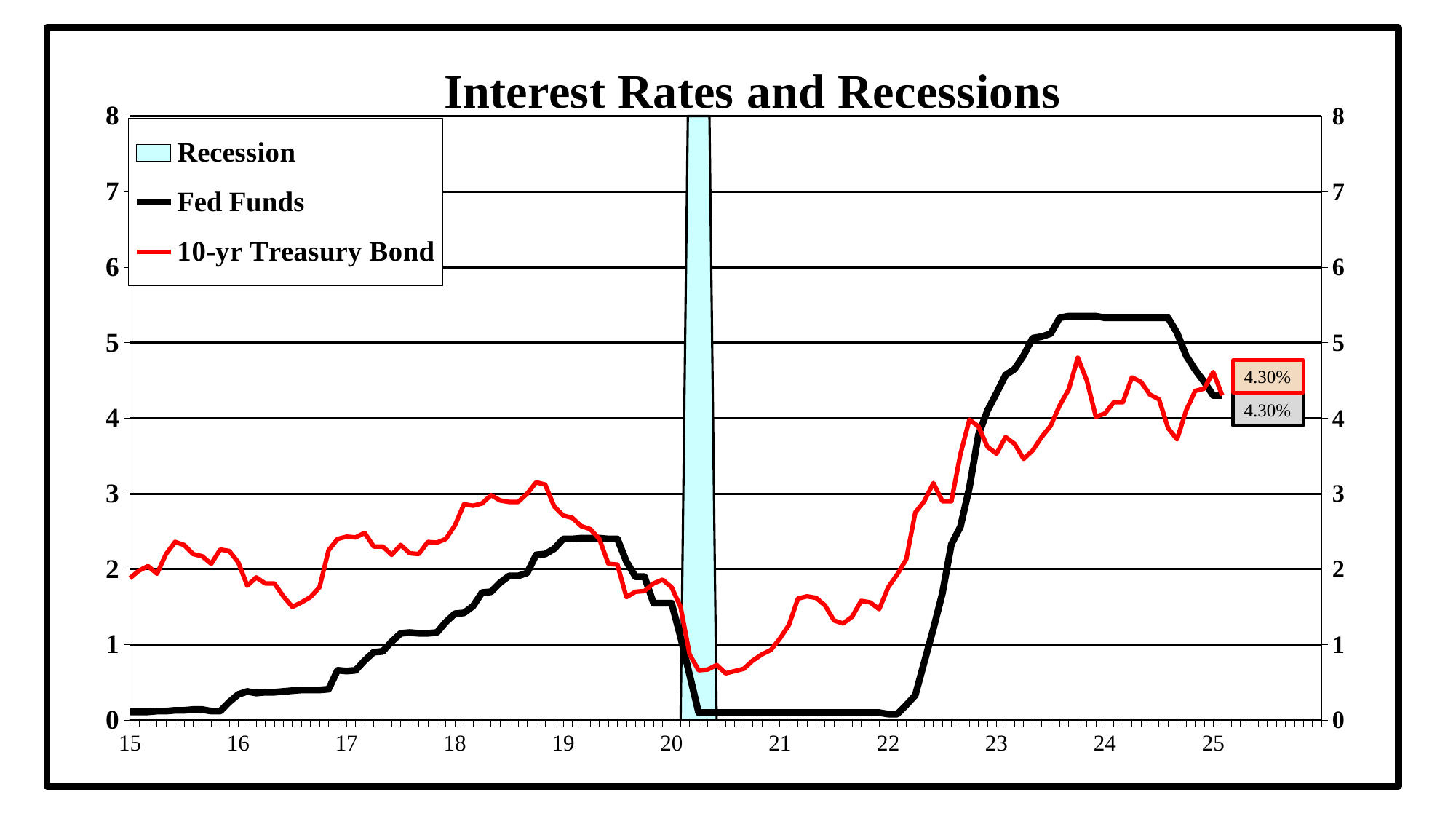
Does the Fed Funds line rise or fall between year 19.5 and year 20.5? fall Does the Fed Funds line rise or fall between year 22 and year 23? rise Is the 10-yr Treasury Bond value at year 16 greater or less than 3? less Is the Fed Funds value at year 24 greater or less than 5? greater What kind of chart is shown on the slide? line chart What is the most recent 10-yr Treasury Bond value shown by the data label at the right end of the chart? 4.30% What is the title of the chart? Interest Rates and Recessions What is the most recent Fed Funds value shown by the data label at the right end of the chart? 4.30% How many entries does the chart's legend list? 3 At year 21, which series is higher: Fed Funds or 10-yr Treasury Bond? 10-yr Treasury Bond Is the Fed Funds value at year 21 greater or less than 1? less What colour is the Fed Funds line? black